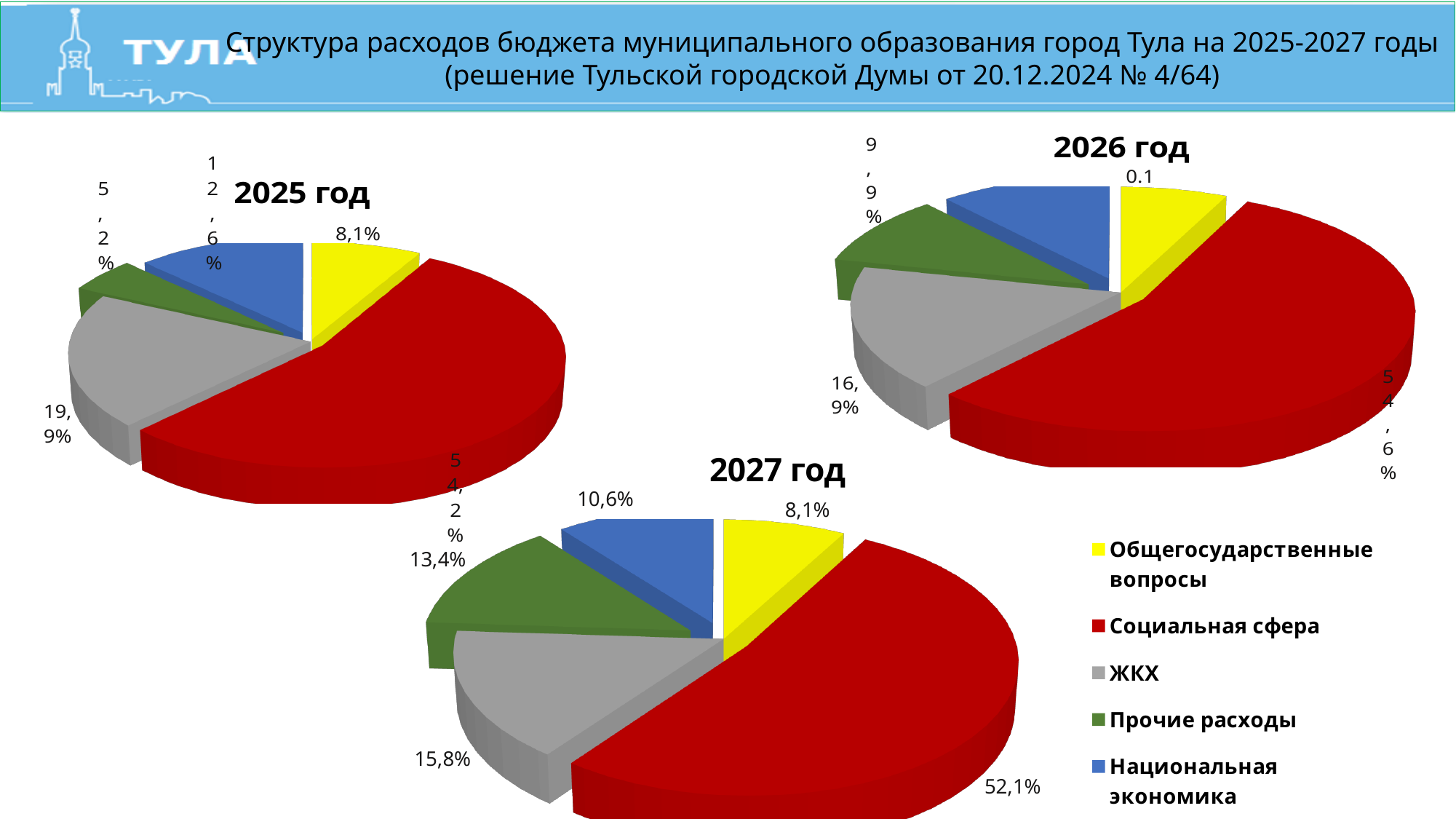
In the 2025 год pie chart, which category has the smallest share? Прочие расходы What type of chart is used for the 2027 год data? Pie chart In the 2027 год pie chart, what is the difference between the shares of Социальная сфера and ЖКХ? 36,3% In the 2025 год pie chart, what share is shown for Национальная экономика? 12,6% In the 2025 год pie chart, which category has the largest share? Социальная сфера In the 2027 год pie chart, which is larger: Прочие расходы or Национальная экономика? Прочие расходы In the 2026 год pie chart, what share is shown for ЖКХ? 16,9% How many categories does the legend list for the pie charts? 5 In the 2027 год pie chart, which category has the smallest share? Общегосударственные вопросы In the 2025 год pie chart, what share is shown for Социальная сфера? 54,2% In the 2026 год pie chart, what share is shown for Социальная сфера? 54,6% In the 2027 год pie chart, what share is shown for ЖКХ? 15,8%